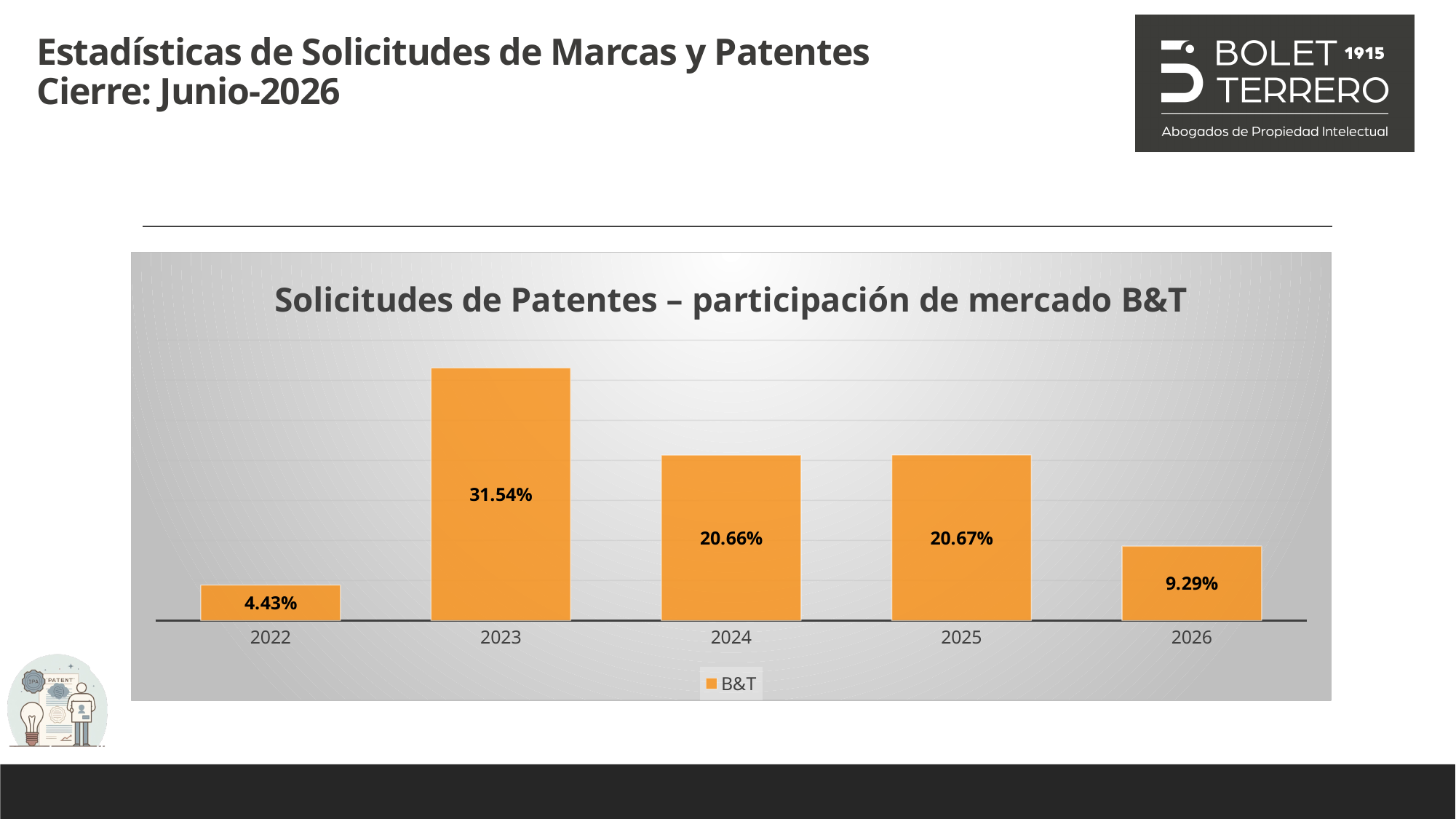
What is the difference between the 2025 and 2026 values? 11.38% What type of chart is shown? Bar chart What is the B&T market share for 2023? 31.54% What is the B&T market share for 2026? 9.29% Which year has the highest B&T market share? 2023 What is the B&T market share for 2024? 20.66% Which is larger, the value for 2023 or the value for 2026? 2023 Which year has the lowest B&T market share? 2022 What is the difference between the 2023 and 2022 values? 27.11% How many series does the legend list? 1 How many years are shown on the x axis? 5 What is the B&T market share for 2022? 4.43%